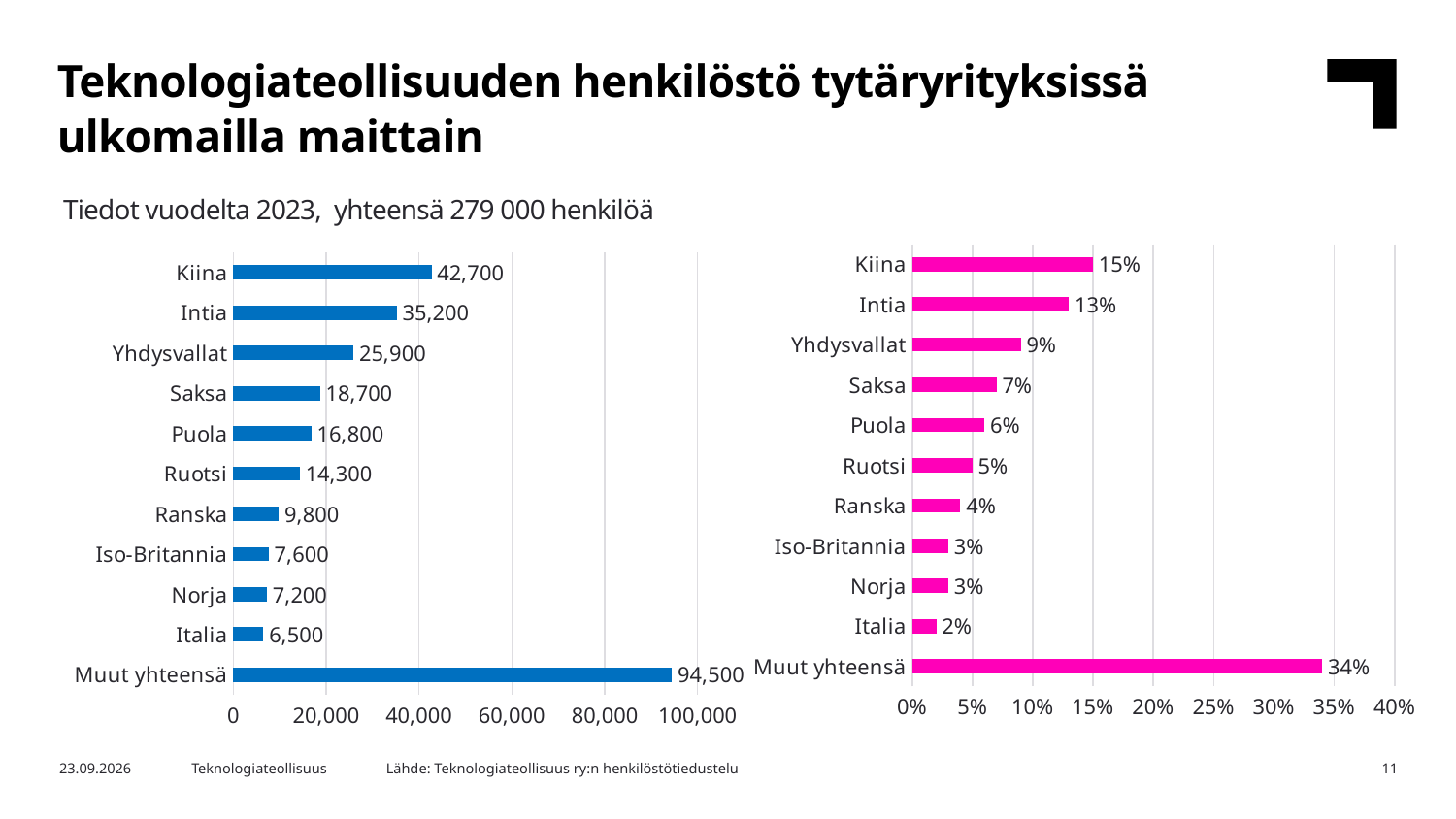
In the left chart (headcount), what is the value for Ruotsi? 14,300 What colour are the bars in the right chart (percentages)? Magenta (pink) In the left chart (headcount), which is larger, Saksa or Puola? Saksa What kind of chart is the right chart (percentages)? Bar chart In the right chart (percentages), what is the difference between Kiina and Yhdysvallat? 6% In the left chart (headcount), what is the value for Kiina? 42,700 In the left chart (headcount), which category has the highest value? Muut yhteensä In the left chart (headcount), which named country has the lowest value? Italia In the left chart (headcount), what is the difference between Kiina and Intia? 7,500 In the right chart (percentages), what is the value for Intia? 13% How many categories are shown in the left chart (headcount)? 11 In the right chart (percentages), what is the value for Muut yhteensä? 34%